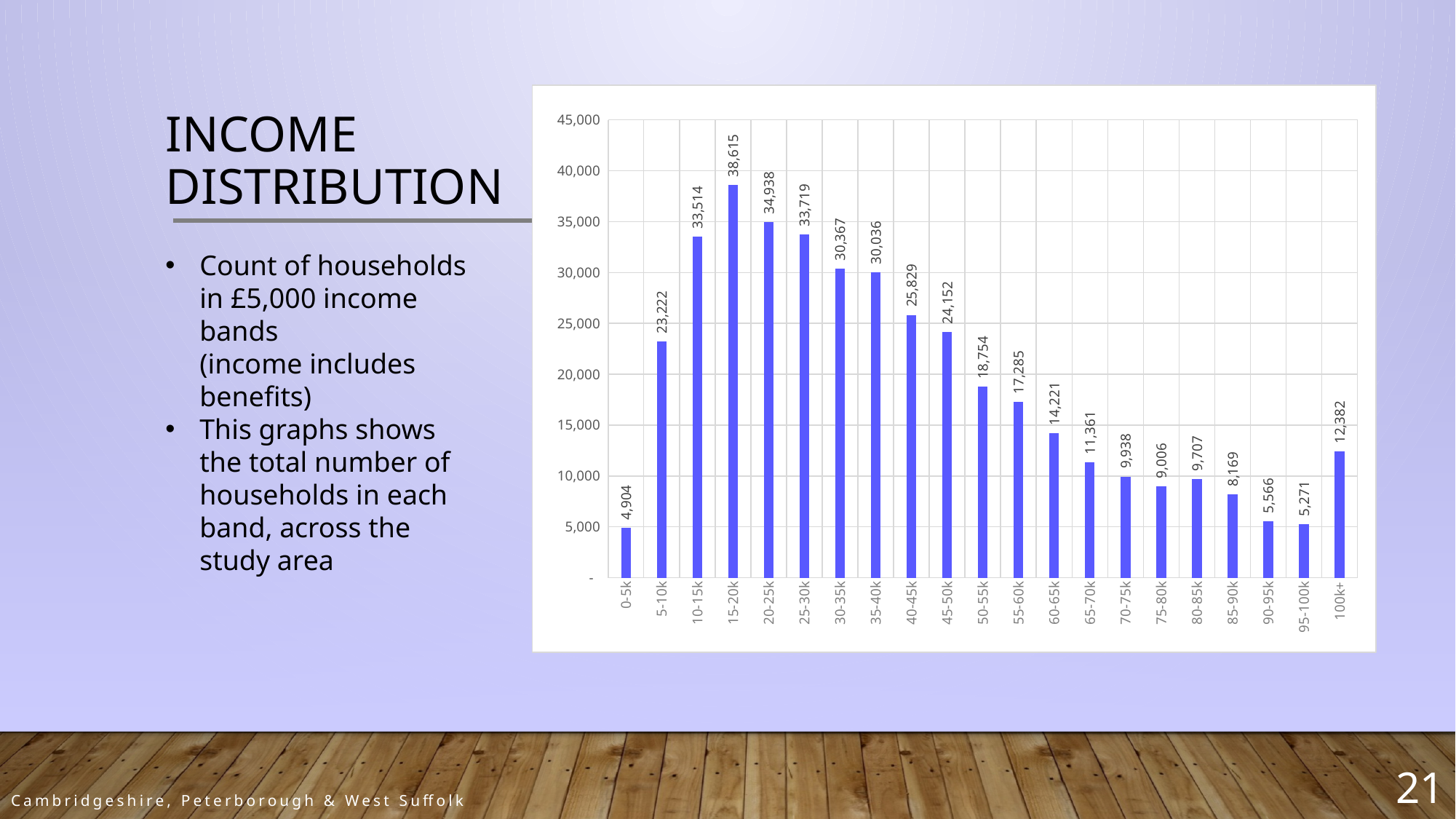
What is the difference between the 15-20k band and the 20-25k band? 3,677 Is the value for the 60-65k band greater or less than 15,000? less How many income bands are shown on the x axis? 21 What is the value shown for the 45-50k band? 24,152 Which income band has the highest number of households? 15-20k What is the count of households in the 100k+ income band? 12,382 How much larger is the 100k+ band than the 95-100k band? 7,111 Which income band has the lowest number of households? 0-5k Which has more households, the 5-10k band or the 45-50k band? 45-50k What is the count of households in the 15-20k income band? 38,615 What kind of chart is shown on the slide? bar chart Do the values rise or fall along the x axis from the 15-20k band to the 95-100k band? fall